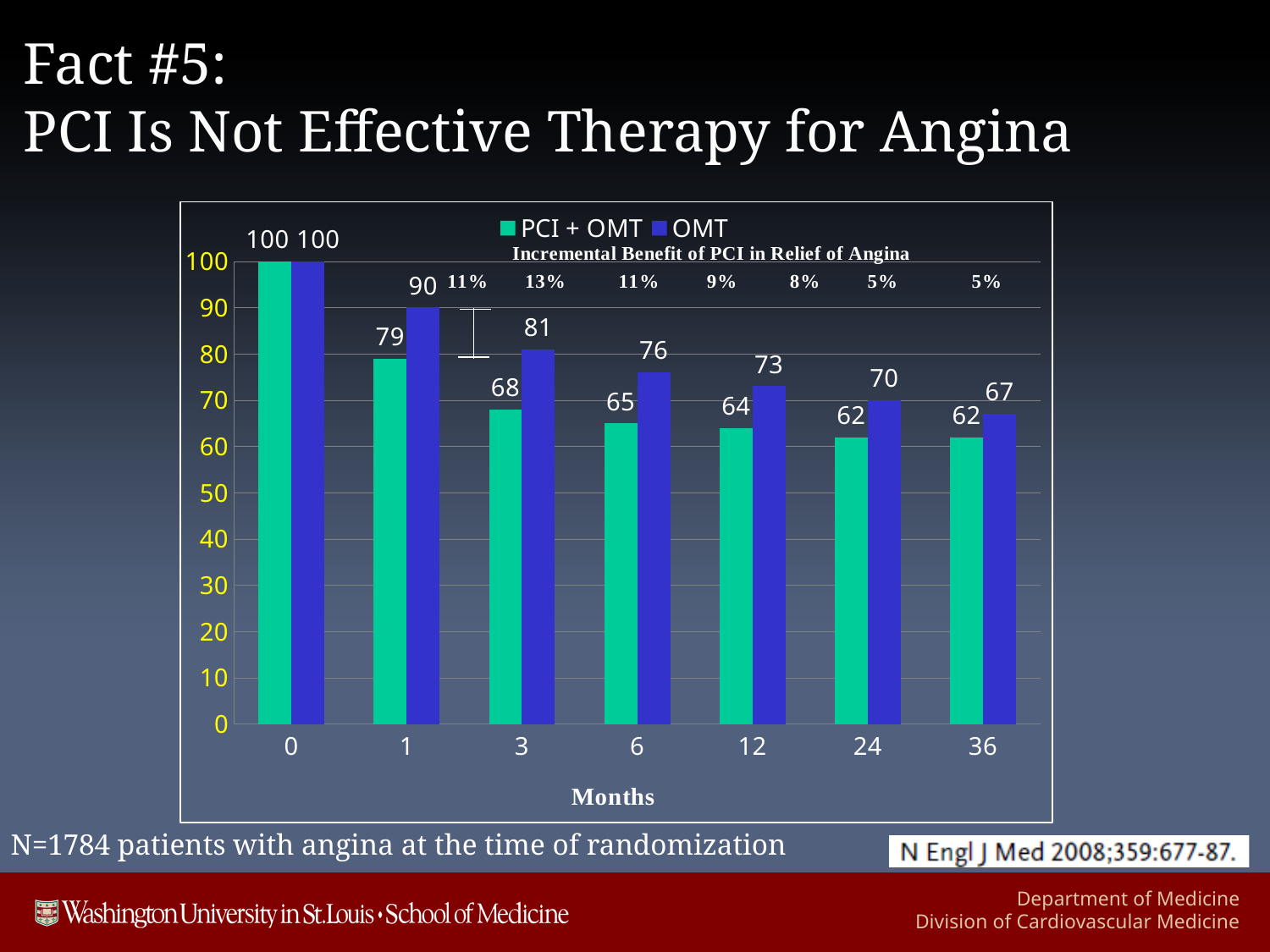
Which is larger at 12 months, the PCI + OMT value or the OMT value? OMT What is the difference between the PCI + OMT values at 1 month and 12 months? 15 How many series does the legend list? 2 How many month categories are shown on the x axis? 7 What is the value for PCI + OMT at 24 months? 62 What is the value for OMT at 6 months? 76 What is the value for OMT at 36 months? 67 What kind of chart is shown on the slide? Bar chart At which month is the OMT value lowest? 36 Do the OMT values rise or fall from 1 month to 36 months? Fall What is the difference between the OMT and PCI + OMT values at 3 months? 13 What is the value for PCI + OMT at 1 month? 79